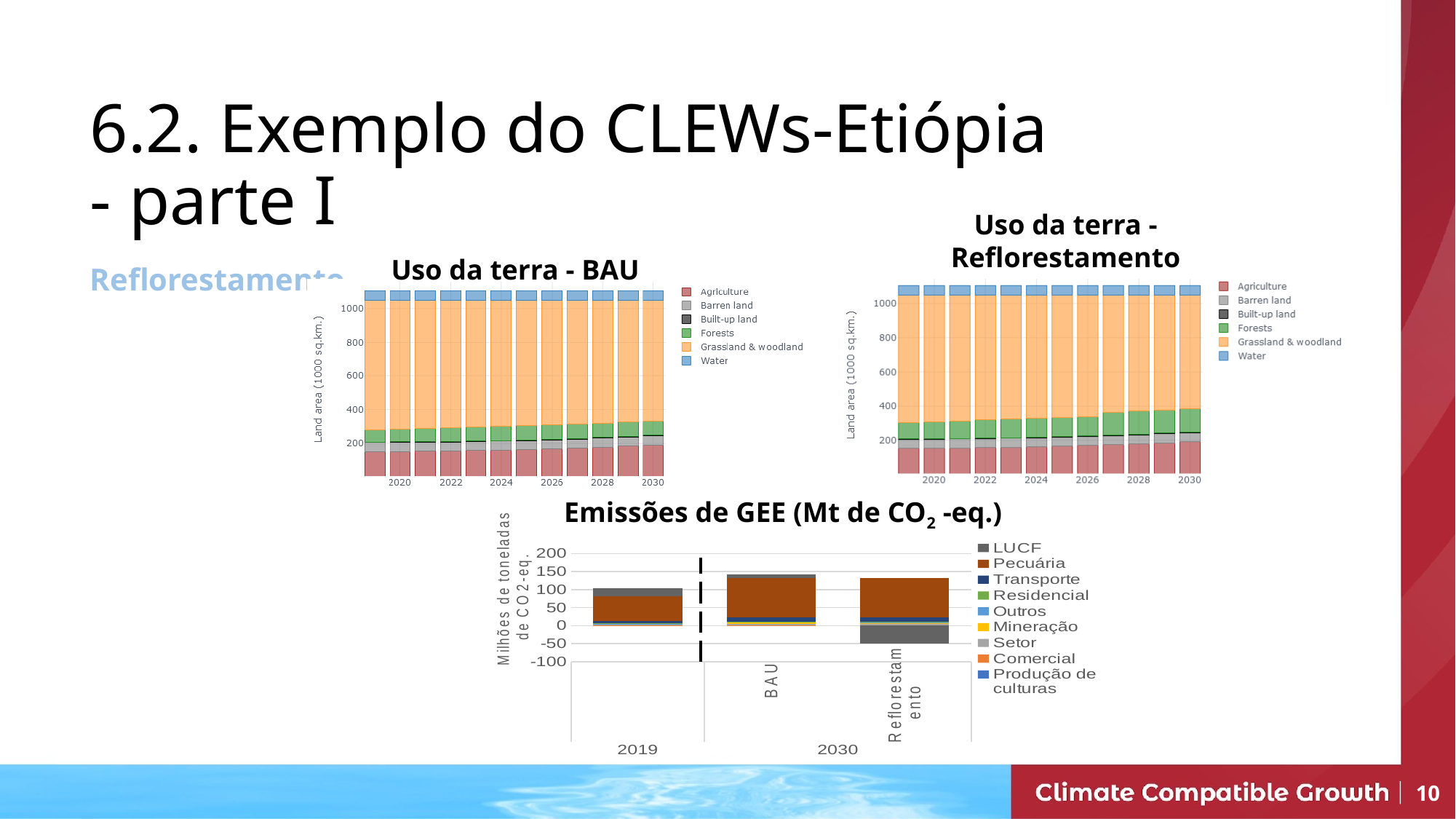
In the "Emissões de GEE" chart, which is larger: the Pecuária segment for BAU in 2030 or the Pecuária segment in 2019? BAU in 2030 What is the y-axis label of the "Uso da terra - Reflorestamento" chart? Land area (1000 sq.km.) What kind of chart is "Uso da terra - BAU"? Stacked bar chart In the "Uso da terra - BAU" chart, which land use category occupies the largest area in 2020? Grassland & woodland In the "Emissões de GEE" chart, is the top of the 2019 stacked bar greater or less than 150? less In the "Uso da terra - BAU" chart, is the total land area in 2020 greater or less than 1000? greater In the "Uso da terra - Reflorestamento" chart, does the Forests segment grow or shrink from 2020 to 2030? Grows In the "Emissões de GEE" chart, is the LUCF value for Reflorestamento in 2030 greater or less than 0? less How many series does the legend of the "Uso da terra - BAU" chart list? 6 How many bars (years) are plotted in the "Uso da terra - Reflorestamento" chart? 11 How many series does the legend of the "Emissões de GEE (Mt de CO2 -eq.)" chart list? 9 In the "Emissões de GEE" chart, which bar has the lowest LUCF value? Reflorestamento (2030)